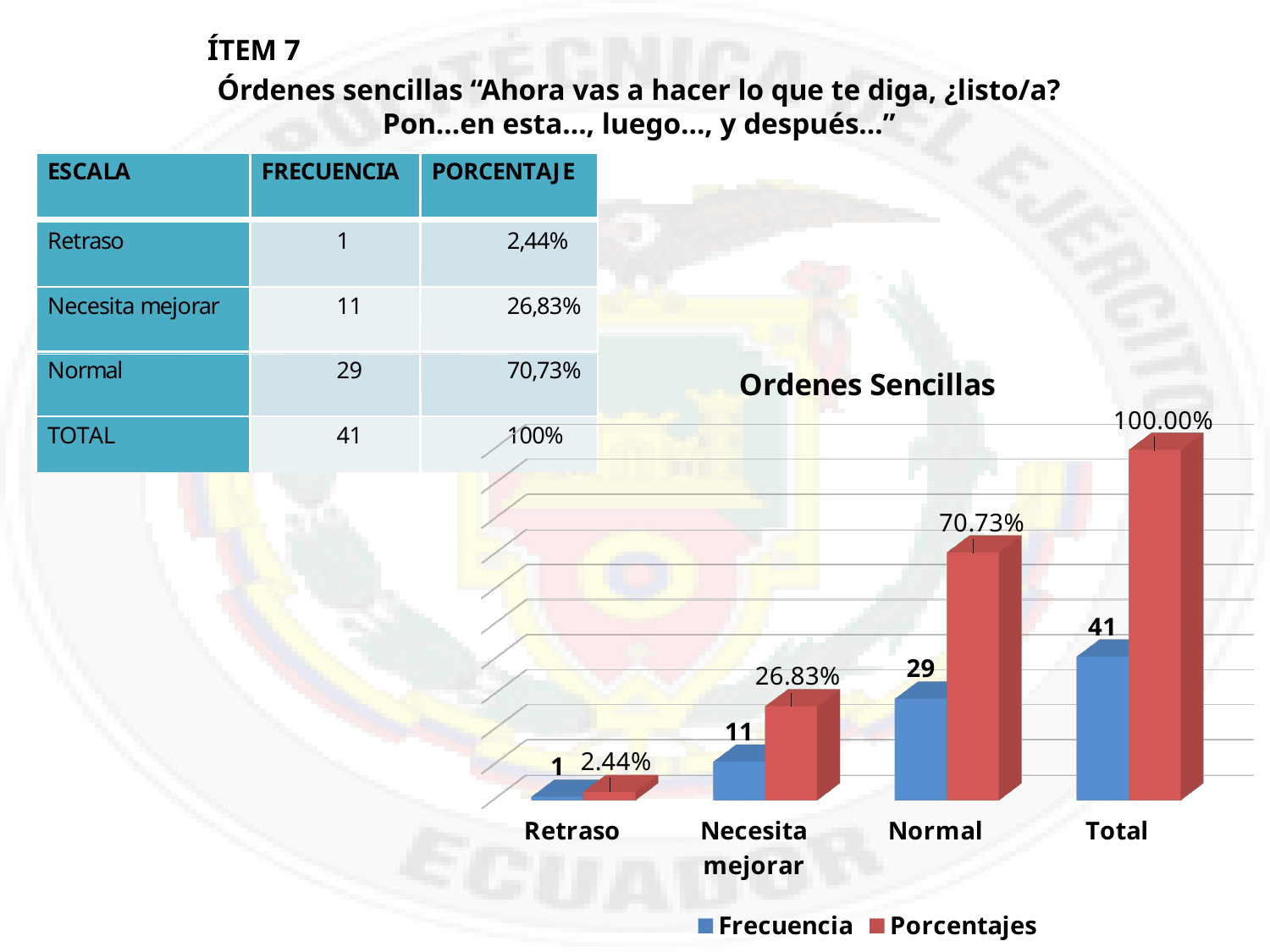
Which series is shown in red in the Ordenes Sencillas chart? Porcentajes What is the Porcentajes value for Necesita mejorar in the Ordenes Sencillas chart? 26.83% What is the Porcentajes value for Total in the Ordenes Sencillas chart? 100.00% What is the difference in Frecuencia between Normal and Necesita mejorar in the Ordenes Sencillas chart? 18 What is the Frecuencia value for Normal in the Ordenes Sencillas chart? 29 Which has a larger Frecuencia in the Ordenes Sencillas chart, Necesita mejorar or Normal? Normal What is the Frecuencia value for Retraso in the Ordenes Sencillas chart? 1 How many categories are shown on the x axis of the Ordenes Sencillas chart? 4 Which category has the lowest Porcentajes value in the Ordenes Sencillas chart? Retraso What kind of chart is the Ordenes Sencillas chart? Bar chart How many series does the legend of the Ordenes Sencillas chart list? 2 Excluding Total, which category has the highest Frecuencia in the Ordenes Sencillas chart? Normal